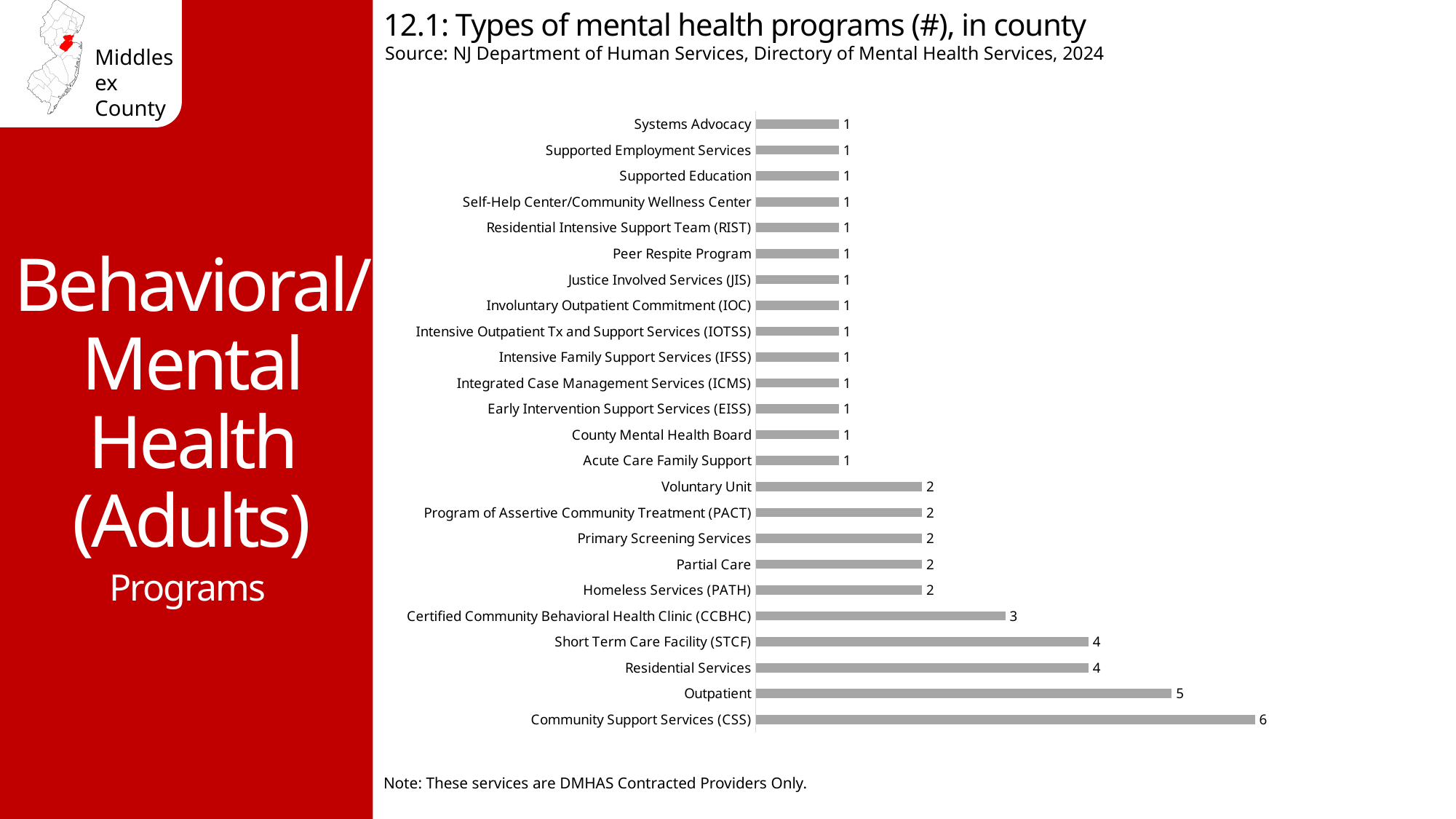
How many categories are shown in the chart? 24 What is the value for Certified Community Behavioral Health Clinic (CCBHC)? 3 What is the value for Peer Respite Program? 1 Which category has the highest value? Community Support Services (CSS) What is the value for Outpatient? 5 Which is larger, the value for Residential Services or the value for Voluntary Unit? Residential Services What is the value for Community Support Services (CSS)? 6 What is the difference between the values for Short Term Care Facility (STCF) and Homeless Services (PATH)? 2 What kind of chart is shown on the slide? Bar chart What is the value for Partial Care? 2 What is the title of the chart? 12.1: Types of mental health programs (#), in county What is the difference between the values for Community Support Services (CSS) and Outpatient? 1